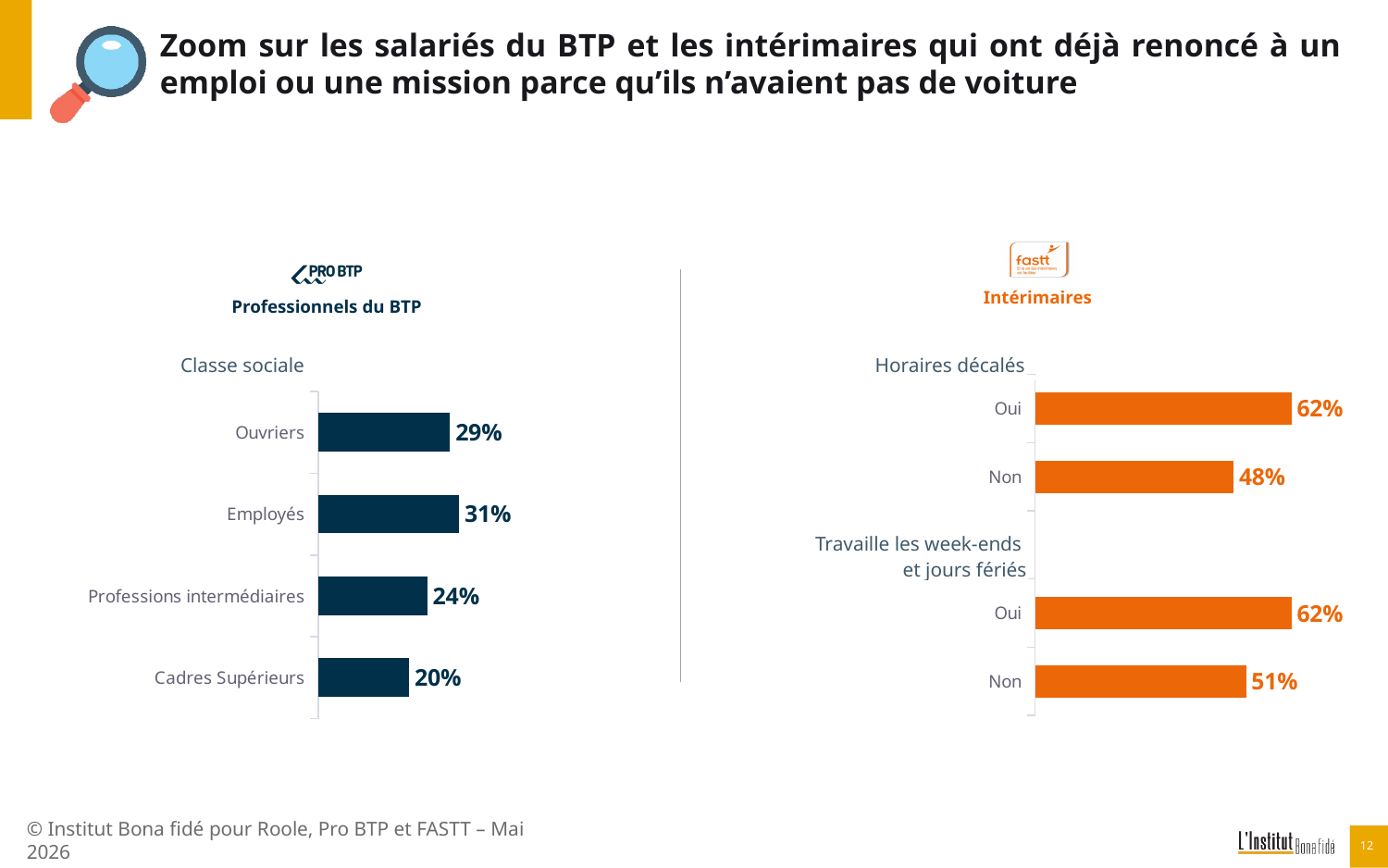
In the 'Professionnels du BTP' chart, which category has the lowest value? Cadres Supérieurs In the 'Professionnels du BTP' chart, what is the value for Ouvriers? 29% In the 'Professionnels du BTP' chart, which category has the highest value? Employés In the 'Intérimaires' chart, what is the value for 'Oui' under Horaires décalés? 62% In the 'Professionnels du BTP' chart, what is the value for Cadres Supérieurs? 20% In the 'Professionnels du BTP' chart, what is the difference between Employés and Professions intermédiaires? 7 percentage points In the 'Intérimaires' chart, what is the value for 'Non' under 'Travaille les week-ends et jours fériés'? 51% In the 'Intérimaires' chart, which is larger: 'Non' under Horaires décalés or 'Non' under 'Travaille les week-ends et jours fériés'? Non under Travaille les week-ends et jours fériés What type of chart is used for the 'Professionnels du BTP' data? Bar chart In the 'Intérimaires' chart, what is the difference between 'Oui' and 'Non' under Horaires décalés? 14 percentage points What colour are the bars in the 'Intérimaires' chart? Orange In the 'Professionnels du BTP' chart, how many categories are shown? 4